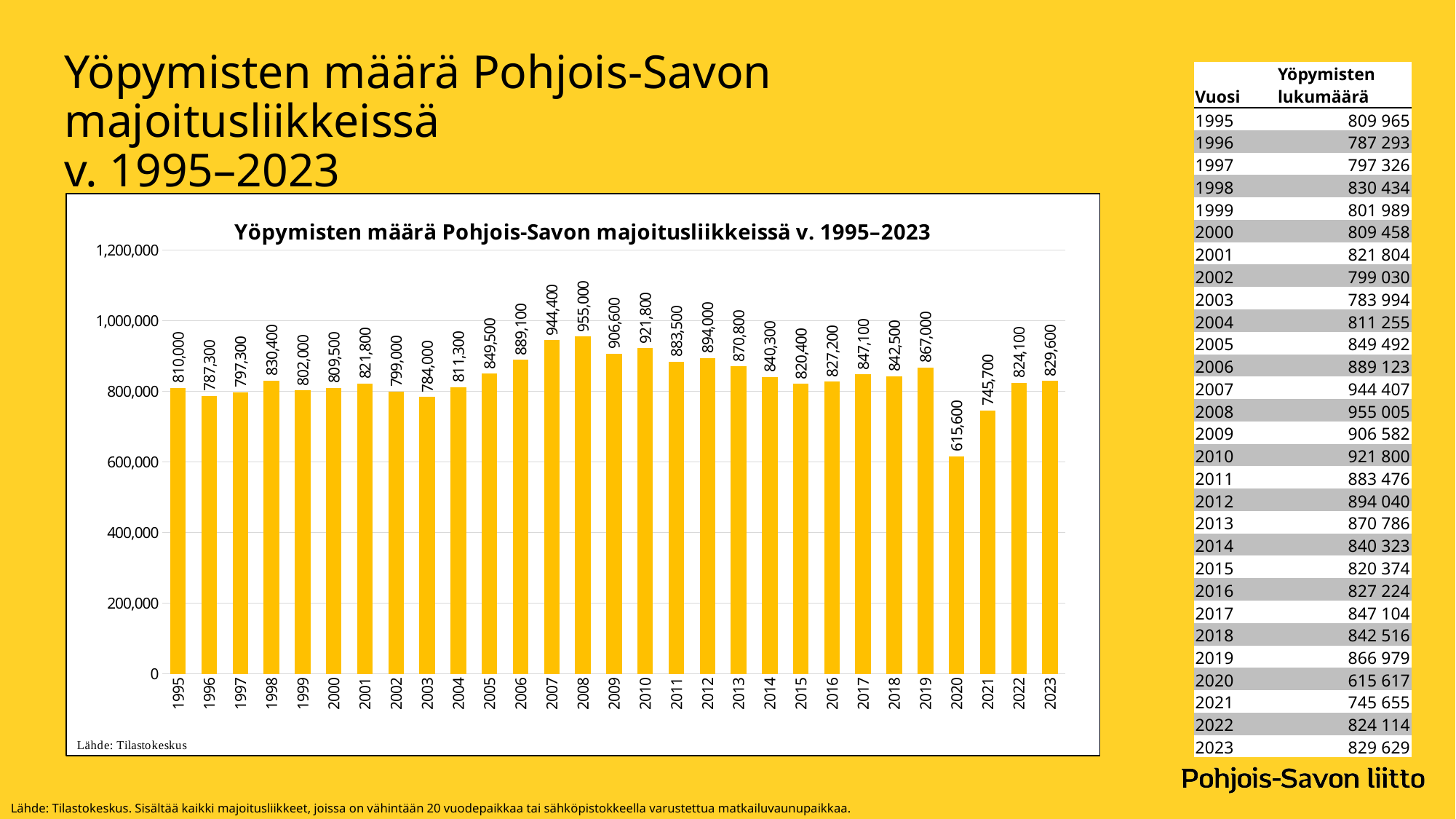
Is the value for 2021 in the chart greater or less than 800,000? less What is the value shown for 2008 in the chart? 955,000 Which is larger in the chart, the value for 2007 or the value for 2010? 2007 What is the value shown for 2020 in the chart? 615,600 What is the title of the chart? Yöpymisten määrä Pohjois-Savon majoitusliikkeissä v. 1995–2023 How many years (bars) are shown in the chart? 29 What is the value shown for 1995 in the chart? 810,000 Which year has the highest value in the chart? 2008 What is the difference between the values for 2008 and 2020 in the chart? 339,400 What kind of chart is shown on the slide? bar chart Which year has the lowest value in the chart? 2020 Do the values in the chart rise or fall from 2019 to 2020? fall